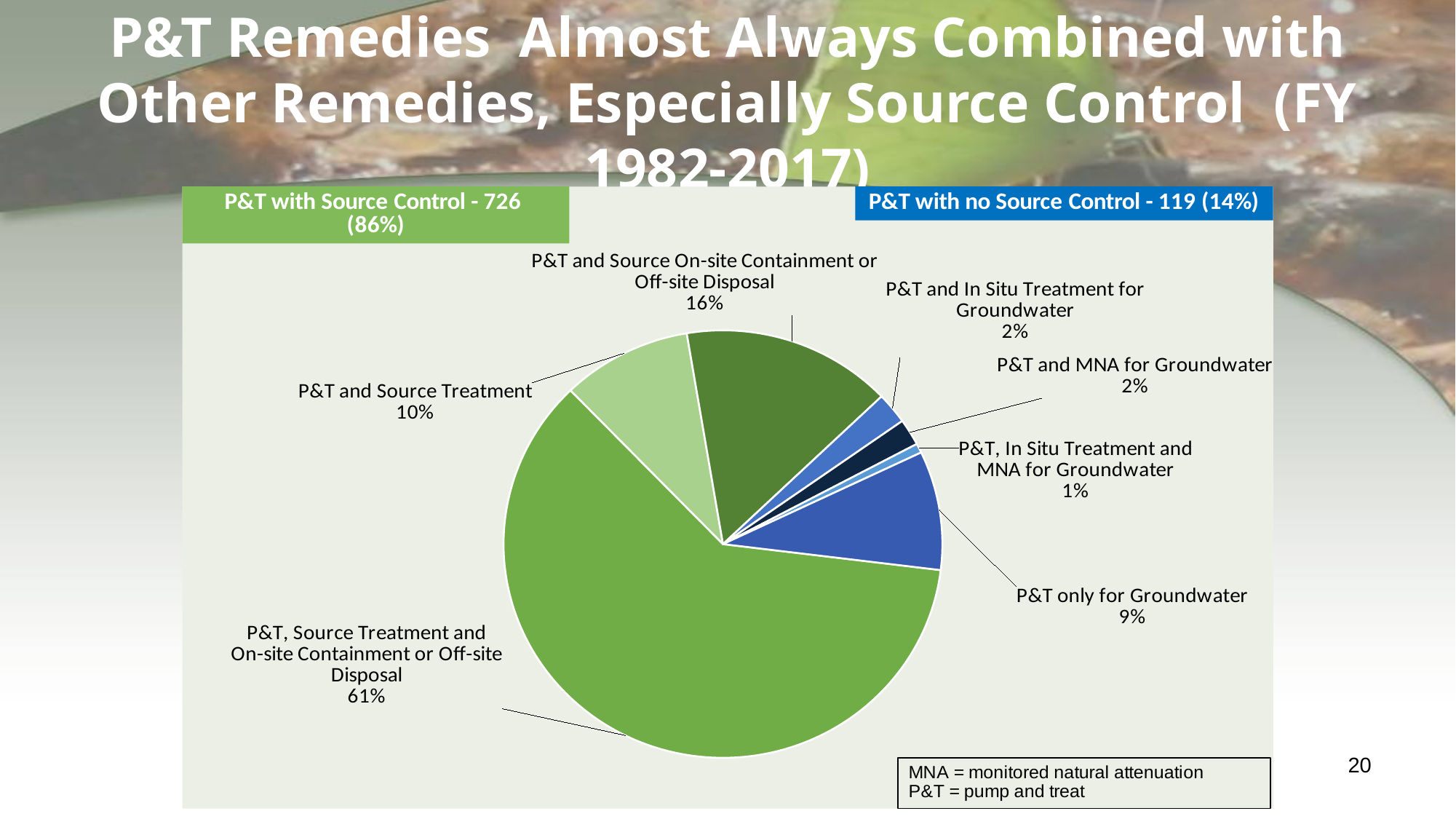
What is the difference in percentage points between 'P&T and Source On-site Containment or Off-site Disposal' and 'P&T only for Groundwater'? 7% What kind of chart is shown on the slide? pie chart What percentage is shown for 'P&T and Source Treatment'? 10% What percentage is shown for 'P&T and Source On-site Containment or Off-site Disposal'? 16% How many P&T remedies are reported with Source Control, according to the green header? 726 How many slices does the pie chart have? 7 According to the blue header, what percentage of P&T remedies have no Source Control? 14% Which slice of the pie is the largest? P&T, Source Treatment and On-site Containment or Off-site Disposal Which slice of the pie is the smallest? P&T, In Situ Treatment and MNA for Groundwater What share of the pie is labelled 'P&T, Source Treatment and On-site Containment or Off-site Disposal'? 61% Which is larger: 'P&T and Source Treatment' or 'P&T only for Groundwater'? P&T and Source Treatment What percentage is shown for 'P&T only for Groundwater'? 9%